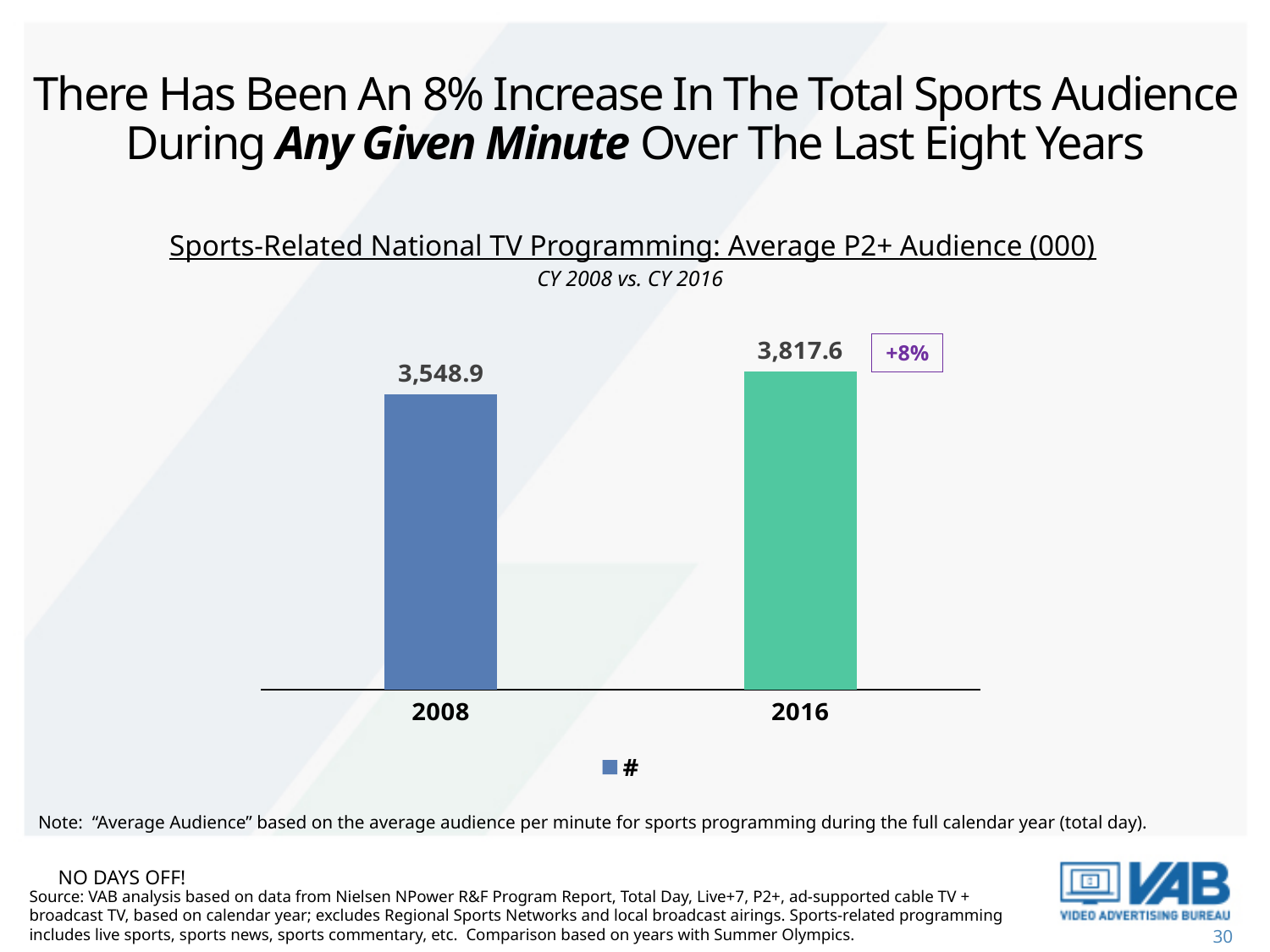
Which year has the lower average P2+ audience? 2008 Is the value for 2016 larger or smaller than the value for 2008? larger What is the average P2+ audience (000) for 2016? 3,817.6 Does the average P2+ audience rise or fall from 2008 to 2016? rise How many series does the legend list? 1 What is the average P2+ audience (000) for 2008? 3,548.9 How many years are plotted in the chart? 2 What is the title of the chart? Sports-Related National TV Programming: Average P2+ Audience (000) What kind of chart is shown on the slide? bar chart What is the difference between the 2016 and 2008 average P2+ audience values (000)? 268.7 What percentage change is annotated next to the 2016 bar? +8% Which year has the higher average P2+ audience? 2016